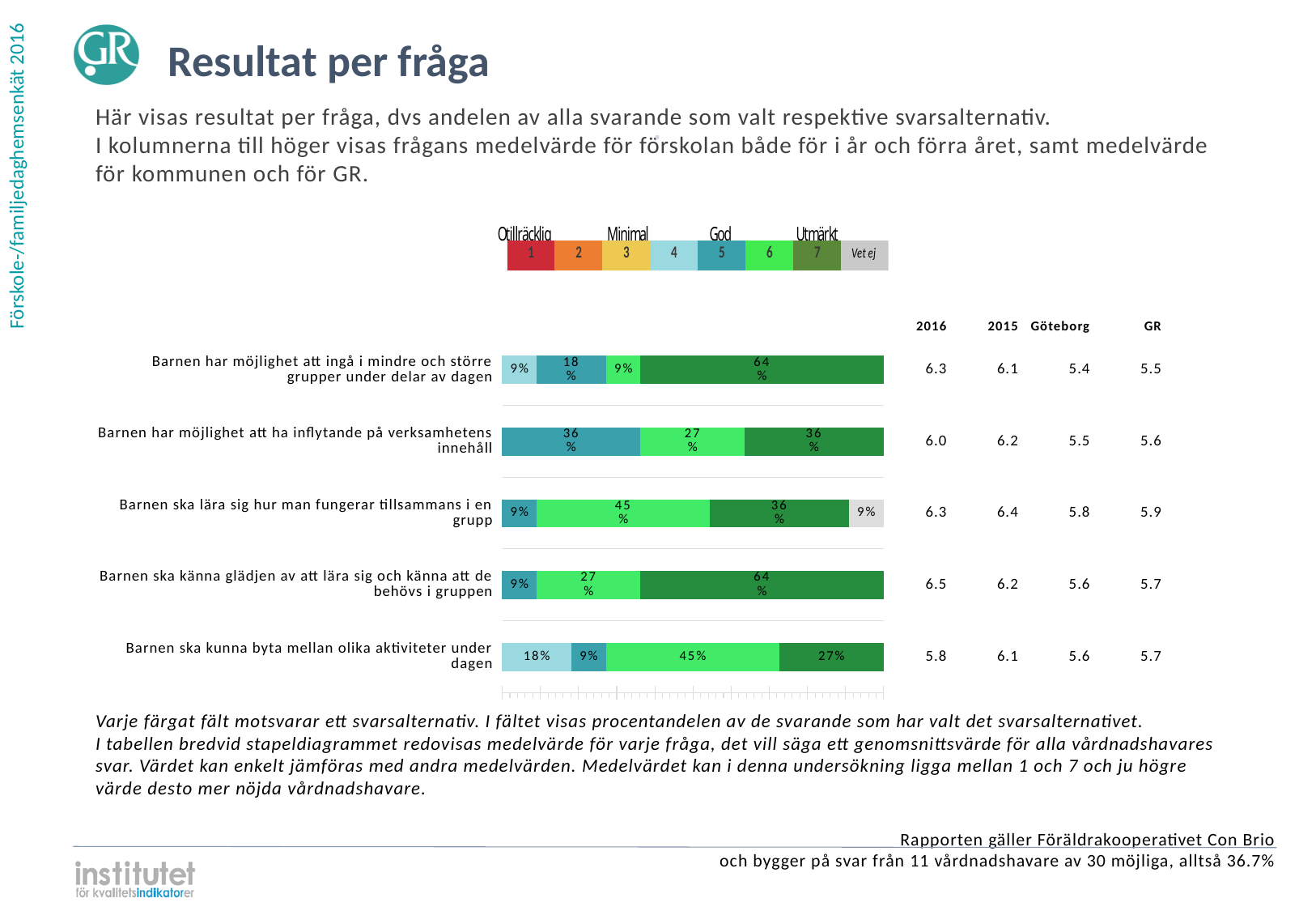
How many answer alternatives does the legend above the chart list? 8 Which question has a "Vet ej" (grey) segment in its bar? Barnen ska lära sig hur man fungerar tillsammans i en grupp What percentage of respondents chose answer 4 (light blue) for "Barnen ska kunna byta mellan olika aktiviteter under dagen"? 18% What is the 2016 mean value shown for "Barnen ska känna glädjen av att lära sig och känna att de behövs i gruppen"? 6.5 What percentage of respondents chose answer 7 (dark green) for "Barnen har möjlighet att ingå i mindre och större grupper under delar av dagen"? 64% What percentage of respondents chose answer 6 (light green) for "Barnen ska lära sig hur man fungerar tillsammans i en grupp"? 45% What is the difference between the answer 7 share for "Barnen ska känna glädjen av att lära sig och känna att de behövs i gruppen" (64%) and for "Barnen ska kunna byta mellan olika aktiviteter under dagen" (27%)? 37 percentage points What percentage of respondents chose answer 5 (teal) for "Barnen har möjlighet att ha inflytande på verksamhetens innehåll"? 36% What kind of chart is shown on the slide? Stacked bar chart How many questions (categories) are plotted in the bar chart? 5 Which is larger: the answer 7 share for "Barnen ska känna glädjen av att lära sig och känna att de behövs i gruppen" or for "Barnen ska kunna byta mellan olika aktiviteter under dagen"? Barnen ska känna glädjen av att lära sig och känna att de behövs i gruppen What is the total of the segments in the bar for "Barnen har möjlighet att ingå i mindre och större grupper under delar av dagen"? 100%